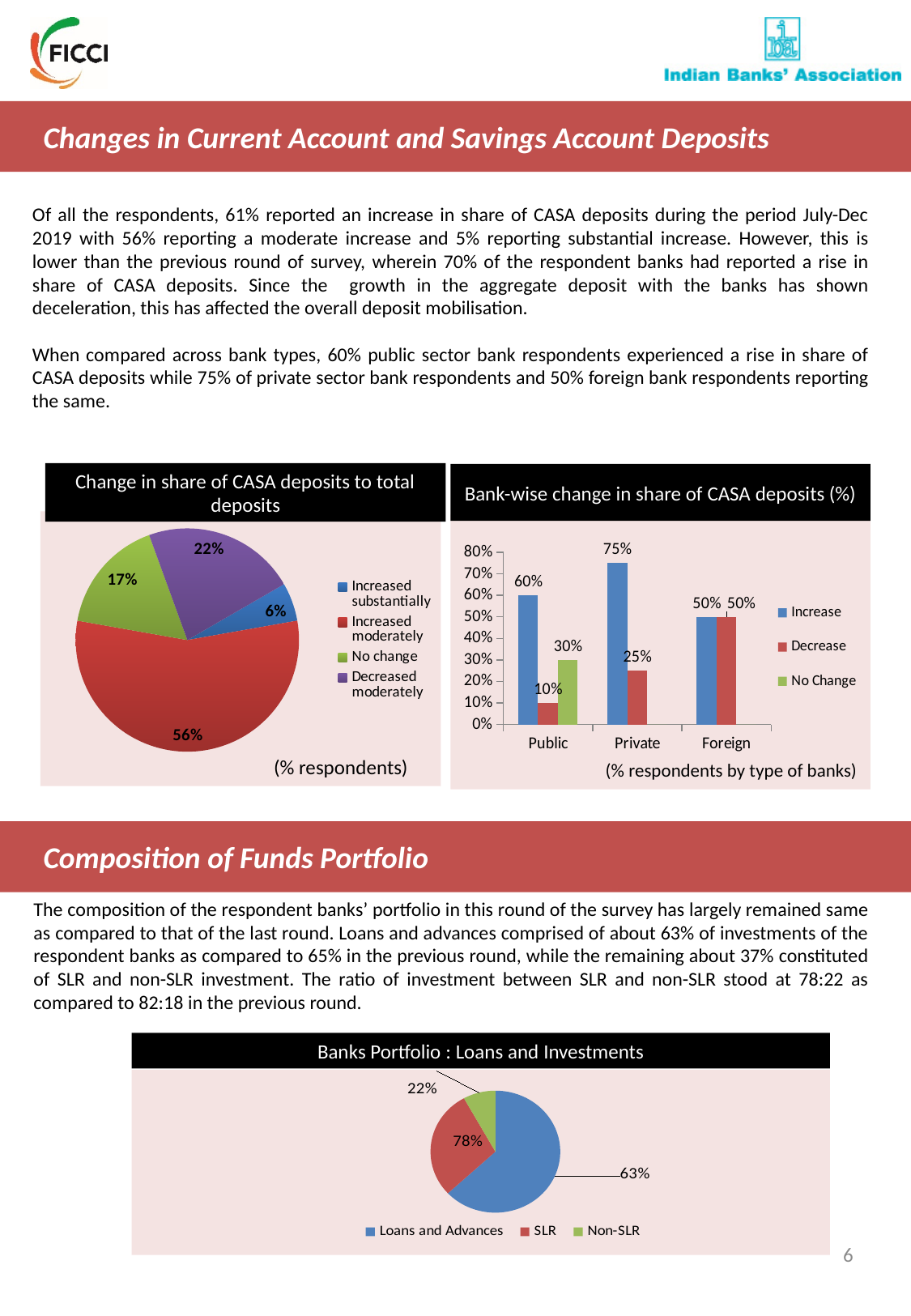
In the 'Banks Portfolio : Loans and Investments' pie chart, which category is shown in blue? Loans and Advances In the 'Change in share of CASA deposits to total deposits' pie chart, what share of respondents reported no change? 17% In the 'Bank-wise change in share of CASA deposits (%)' chart, how many series does the legend list? 3 In the 'Bank-wise change in share of CASA deposits (%)' chart, which bank type has the highest Increase value? Private In the 'Change in share of CASA deposits to total deposits' pie chart, what percentage of respondents reported an increase moderately? 56% In the 'Banks Portfolio : Loans and Investments' pie chart, what percentage is shown for Loans and Advances? 63% What kind of chart is 'Bank-wise change in share of CASA deposits (%)'? Bar chart In the 'Change in share of CASA deposits to total deposits' pie chart, how many categories does the legend list? 4 In the 'Change in share of CASA deposits to total deposits' pie chart, which category has the smallest slice? Increased substantially In the 'Bank-wise change in share of CASA deposits (%)' chart, what is the difference between the Increase and Decrease values for Public banks? 50% In the 'Bank-wise change in share of CASA deposits (%)' chart, what is the No Change value for Public banks? 30% In the 'Bank-wise change in share of CASA deposits (%)' chart, what is the Increase value for Private banks? 75%